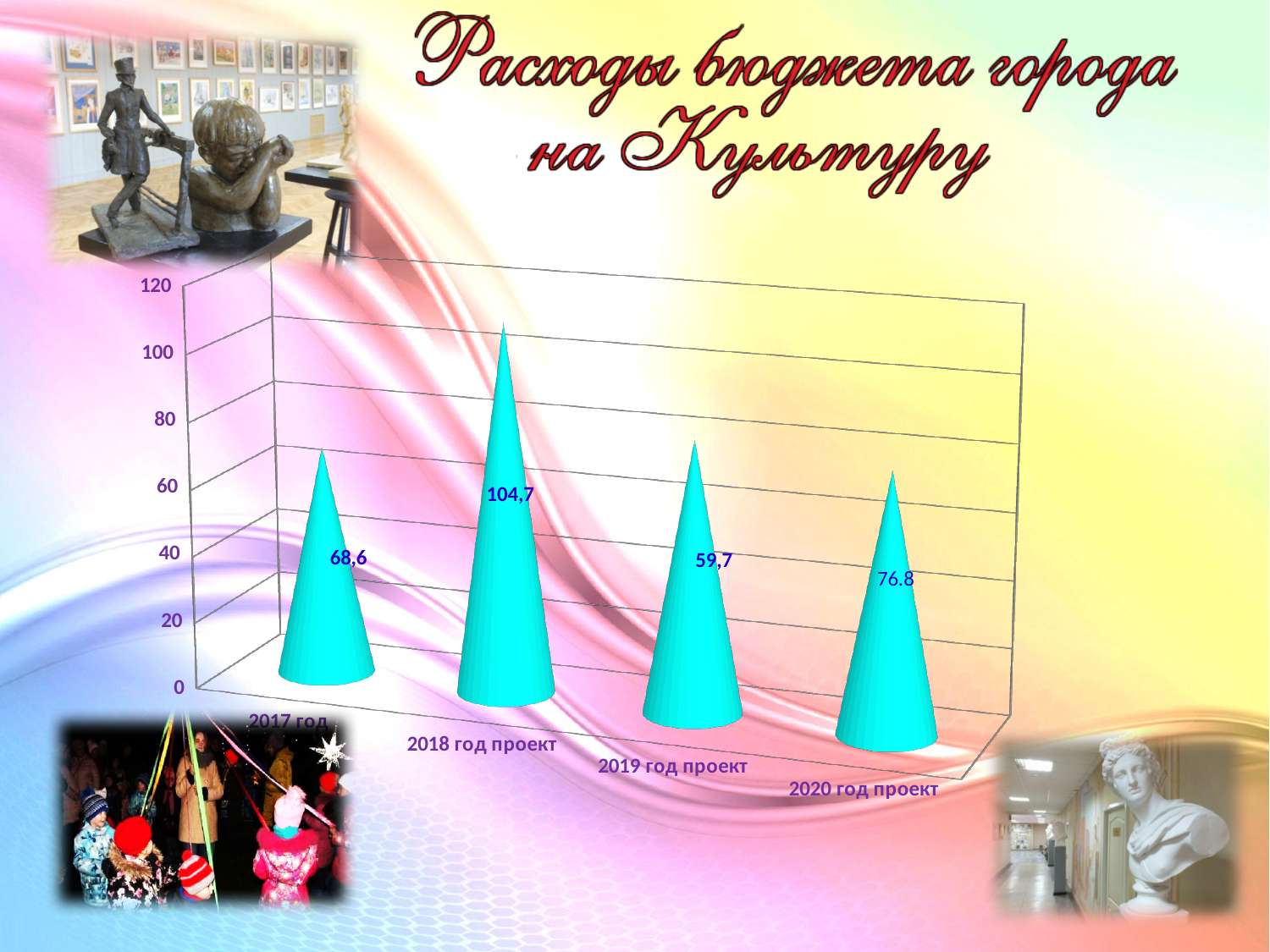
What is the value for 2018 год проект? 104,7 Which is larger, the value for 2020 год проект or the value for 2017 год? 2020 год проект Is the value for 2018 год проект greater or less than 100? greater Which category has the lowest value? 2019 год проект What is the value for 2019 год проект? 59,7 What is the difference between the values for 2018 год проект and 2019 год проект? 45 What is the title of the chart? Расходы бюджета города на Культуру What is the value for 2020 год проект? 76.8 Which category has the highest value? 2018 год проект What is the difference between the values for 2018 год проект and 2017 год? 36,1 What is the value for 2017 год? 68,6 How many categories are shown on the x axis? 4